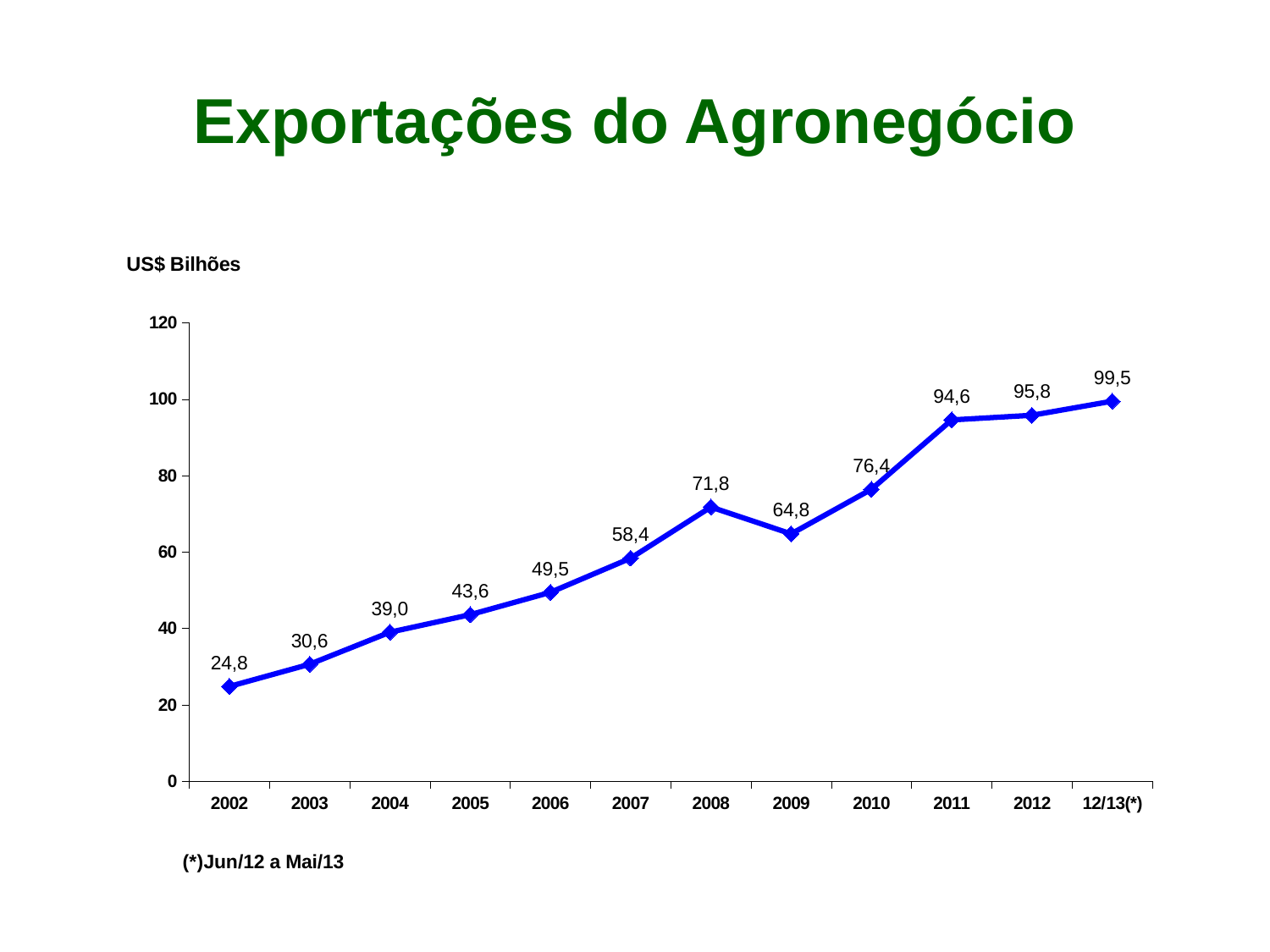
What is the title of the chart? Exportações do Agronegócio What is the value for 2008? 71,8 How many data points are plotted on the chart? 12 What is the value for 2002? 24,8 What kind of chart is shown? line chart Do the values generally rise or fall from 2002 to 12/13(*)? rise What is the difference between the values for 2010 and 2009? 11,6 Which year has the lowest value? 2002 Which year has the highest value? 12/13(*) Is the value for 2011 greater or less than 80? greater What is the value for 12/13(*)? 99,5 Which is larger, the value for 2008 or the value for 2009? 2008